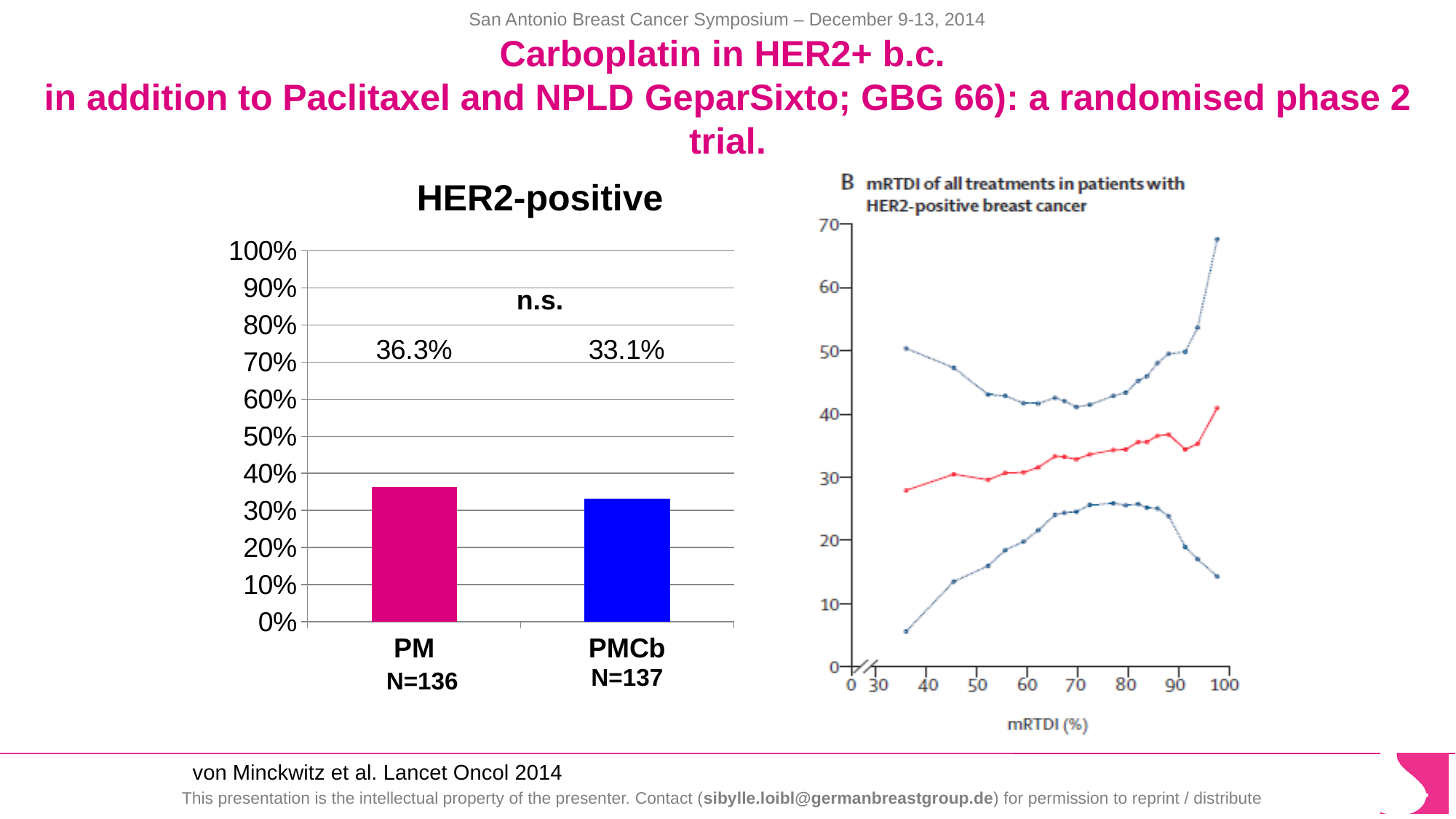
In the HER2-positive bar chart, what is the difference between the PM and PMCb values? 3.2% In the HER2-positive bar chart, what is the value for PMCb? 33.1% In the HER2-positive bar chart, what is the value for PM? 36.3% In the HER2-positive bar chart, how many categories are shown? 2 What kind of chart is the HER2-positive chart on the left? bar chart In the HER2-positive bar chart, is the value for PM greater or less than 40%? less In the HER2-positive bar chart, what annotation is printed above the bars about statistical significance? n.s. In the mRTDI chart on the right, does the red line rise or fall as mRTDI (%) increases along the x axis? rise In the HER2-positive bar chart, what is the number of patients (N) for the PMCb group? N=137 In the HER2-positive bar chart, which category has the higher value? PM What kind of chart is the mRTDI chart on the right? line chart In the HER2-positive bar chart, which category has the lower value? PMCb